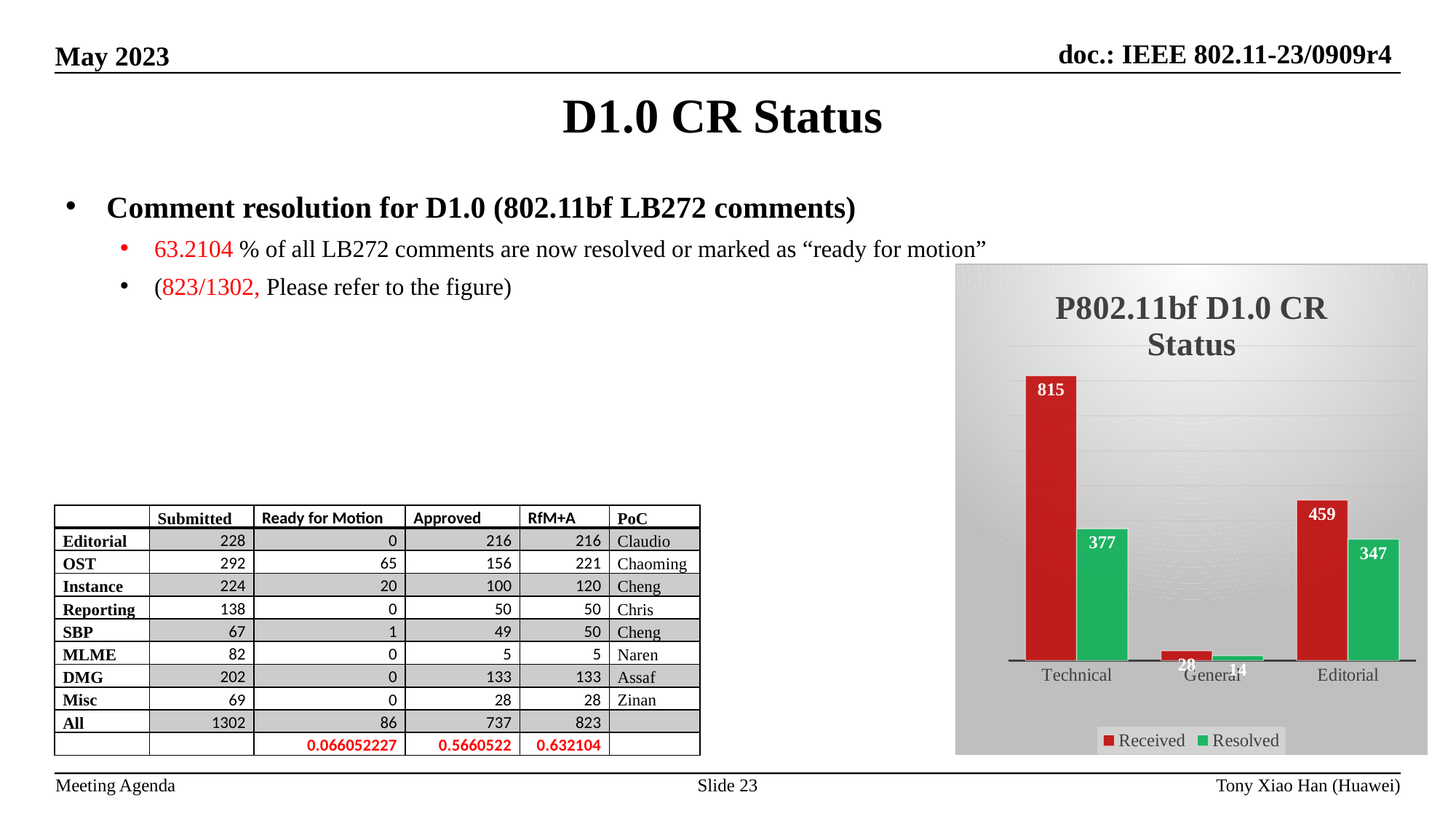
What is the difference between the Received and Resolved values for Technical? 438 How many series does the chart legend list? 2 Which category has the lowest Resolved value? General Which category has the highest Received value? Technical What is the Resolved value for Editorial? 347 Which is larger, the Received value for Editorial or the Resolved value for Technical? Received value for Editorial What is the title of the chart? P802.11bf D1.0 CR Status What type of chart is shown on the slide? bar chart How many categories are shown on the x axis of the chart? 3 What is the Resolved value for Technical? 377 What is the Received value for Technical? 815 What is the Received value for General? 28